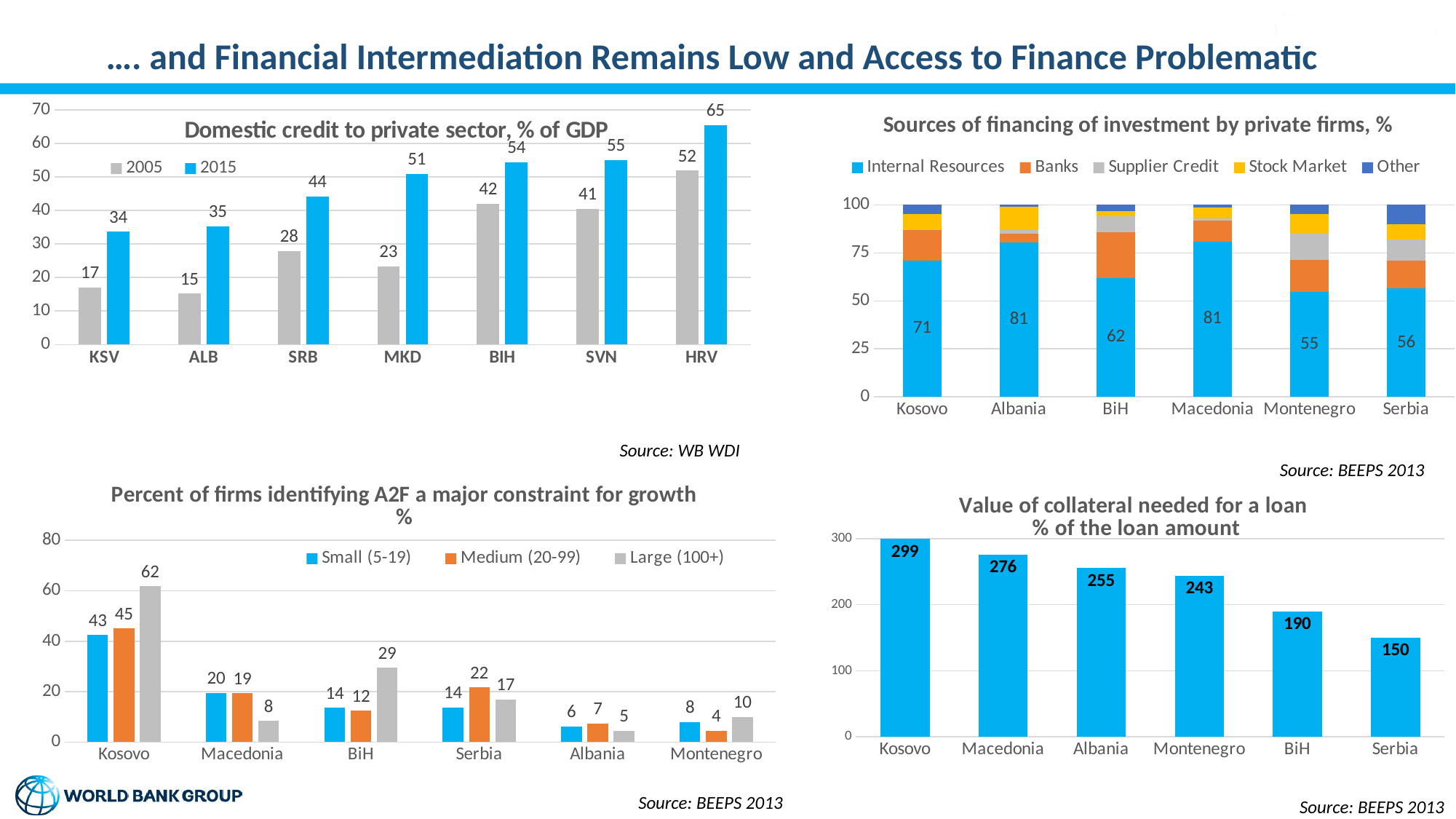
In the 'Sources of financing of investment by private firms, %' chart, what is the Internal Resources value for Montenegro? 55 In the 'Percent of firms identifying A2F a major constraint for growth %' chart, which is larger for Serbia: Small (5-19) or Medium (20-99)? Medium (20-99) In the 'Value of collateral needed for a loan % of the loan amount' chart, what is the value for Albania? 255 In the 'Domestic credit to private sector, % of GDP' chart, which country has the highest 2015 value? HRV In the 'Domestic credit to private sector, % of GDP' chart, what is the 2015 value for MKD? 51 In the 'Percent of firms identifying A2F a major constraint for growth %' chart, what is the value for Large (100+) firms in BiH? 29 In the 'Sources of financing of investment by private firms, %' chart, which country has the lowest Internal Resources value? Montenegro In the 'Value of collateral needed for a loan % of the loan amount' chart, do the values rise or fall from left to right along the x axis? fall In the 'Sources of financing of investment by private firms, %' chart, how many series does the legend list? 5 In the 'Value of collateral needed for a loan % of the loan amount' chart, what is the difference between Kosovo and Serbia? 149 In the 'Domestic credit to private sector, % of GDP' chart, what is the difference between the 2015 and 2005 values for KSV? 17 In the 'Domestic credit to private sector, % of GDP' chart, how many countries are shown on the x axis? 7